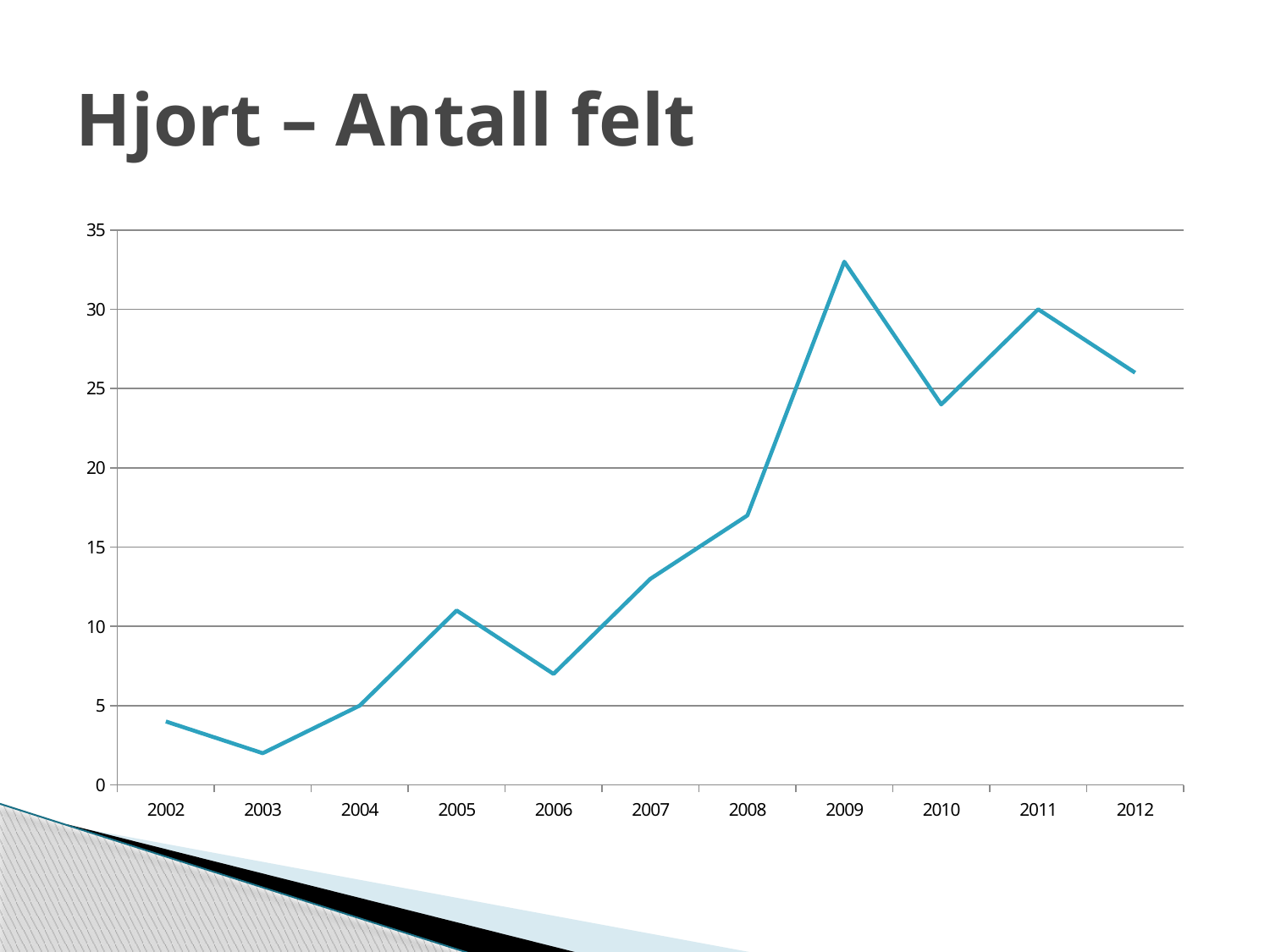
Is the value for 2008 greater or less than 15? greater Which year has the larger value, 2005 or 2006? 2005 What is the value for 2004? 5 Which year has the highest value? 2009 Which year has the lowest value? 2003 Is the value for 2009 greater or less than 30? greater How many years are plotted on the x axis? 11 What is the title of the chart? Hjort – Antall felt What kind of chart is shown on the slide? line chart Is the value for 2010 greater or less than 25? less What is the value for 2011? 30 Overall, do the values rise or fall from 2002 to 2012? rise